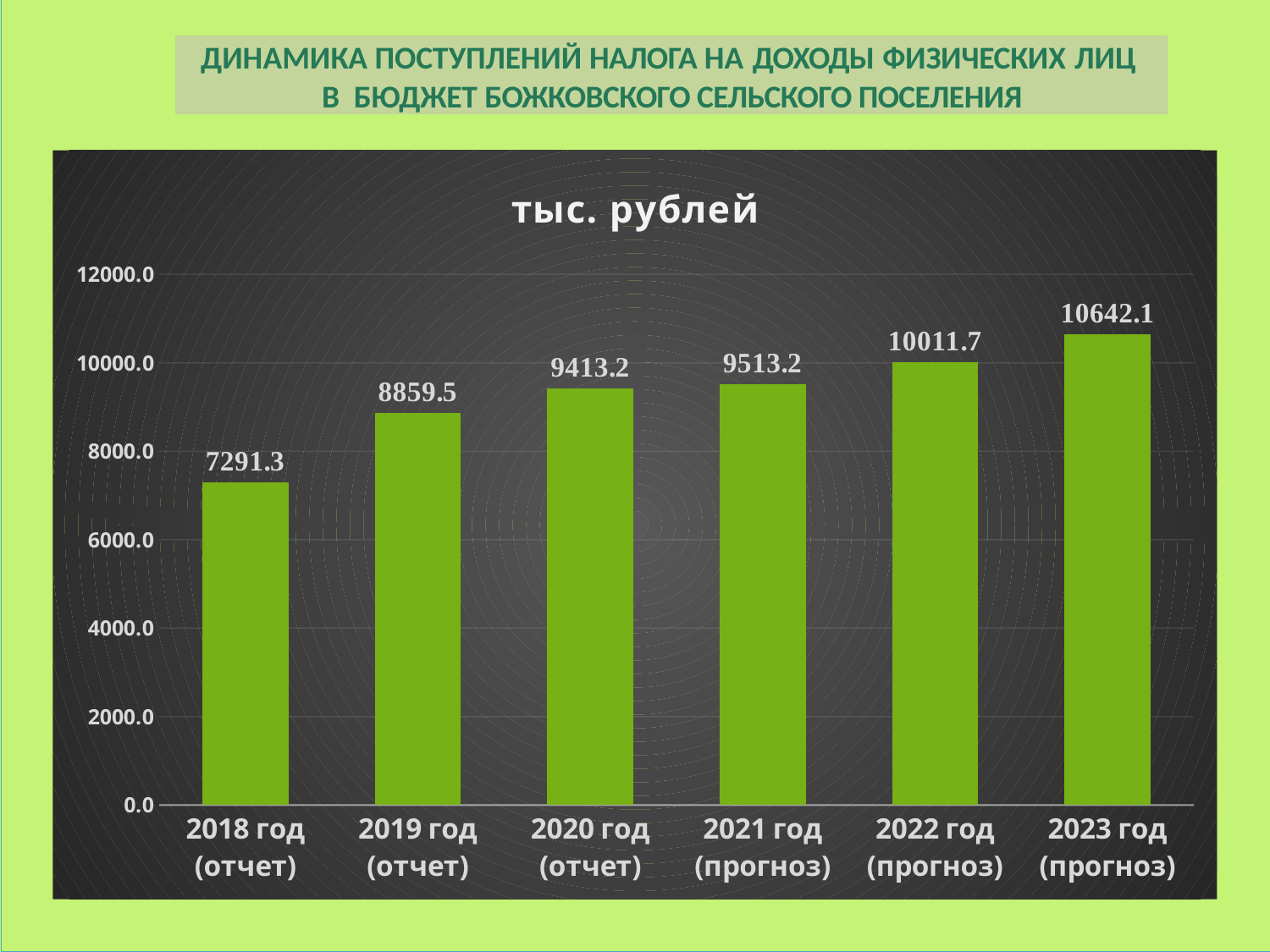
How many years are shown on the chart? 6 Do the values rise or fall from 2018 to 2023? rise What is the difference between the values for 2023 год (прогноз) and 2022 год (прогноз)? 630.4 Which is larger, the value for 2020 год (отчет) or 2022 год (прогноз)? 2022 год (прогноз) What is the value for 2021 год (прогноз)? 9513.2 What is the difference between the values for 2019 год (отчет) and 2018 год (отчет)? 1568.2 What kind of chart is shown on the slide? bar chart What is the value for 2023 год (прогноз)? 10642.1 Which year has the highest value? 2023 год (прогноз) Is the value for 2019 год (отчет) greater or less than 8000.0? greater Which year has the lowest value? 2018 год (отчет) What is the value for 2018 год (отчет)? 7291.3